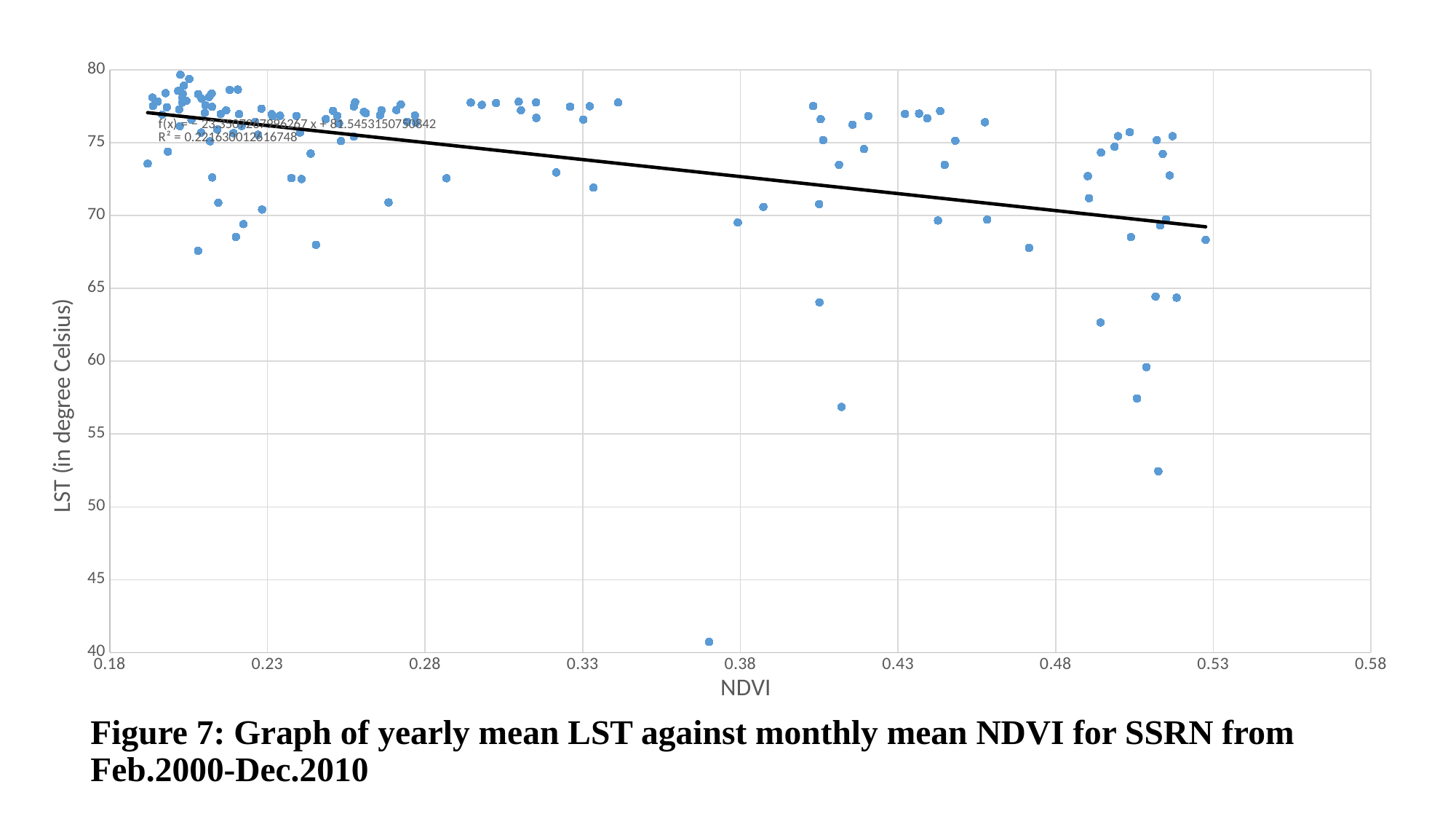
Is the NDVI of the point with the lowest LST greater or less than 0.33? greater Is the highest LST value plotted greater or less than 75? greater What is the label of the vertical axis? LST (in degree Celsius) Is the lowest LST value plotted greater or less than 45? less What kind of chart is shown on the slide? scatter plot What is the figure caption below the chart? Figure 7: Graph of yearly mean LST against monthly mean NDVI for SSRN from Feb.2000-Dec.2010 Does the fitted trendline rise or fall as NDVI increases along the x axis? falls